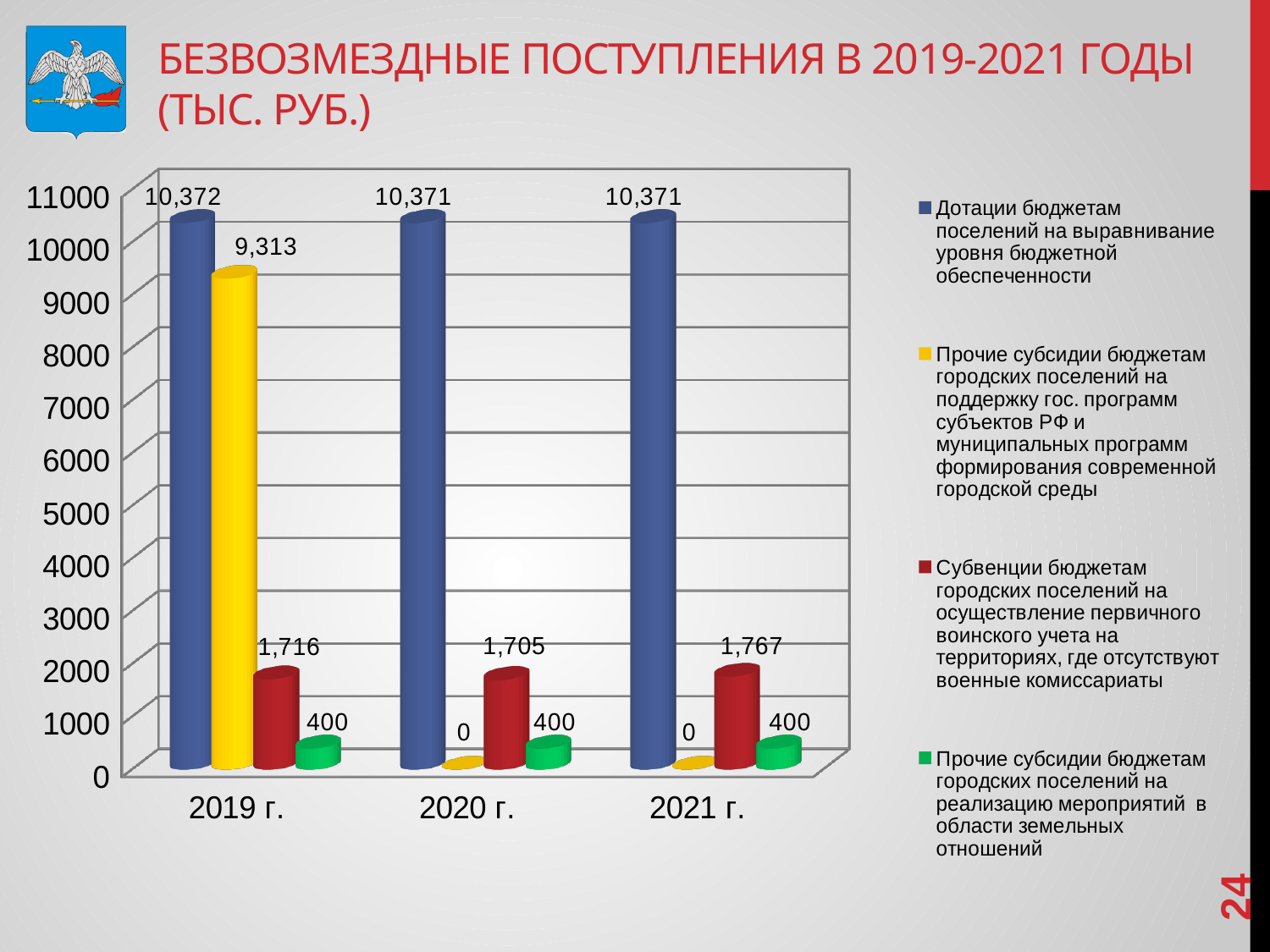
What is the value of the yellow series ('Прочие субсидии ... городской среды') for 2020 г.? 0 What is the value of 'Дотации бюджетам поселений на выравнивание уровня бюджетной обеспеченности' for 2019 г.? 10,372 In which year is the value of 'Субвенции бюджетам городских поселений на осуществление первичного воинского учета' the highest? 2021 г. How many series does the legend list? 4 How many years (categories) are shown on the x axis? 3 What kind of chart is shown on the slide? Bar chart Which is larger in 2019 г.: the 'Дотации' value or the 'Прочие субсидии ... городской среды' value? Дотации (10,372) What is the value of 'Субвенции бюджетам городских поселений на осуществление первичного воинского учета' for 2021 г.? 1,767 What is the difference between the 'Дотации' value for 2019 г. and the 'Прочие субсидии ... городской среды' value for 2019 г.? 1,059 What is the value of 'Прочие субсидии бюджетам городских поселений на реализацию мероприятий в области земельных отношений' for 2020 г.? 400 In which year is the value of 'Субвенции бюджетам городских поселений на осуществление первичного воинского учета' the lowest? 2020 г. What is the value of 'Прочие субсидии бюджетам городских поселений на поддержку гос. программ субъектов РФ и муниципальных программ формирования современной городской среды' for 2019 г.? 9,313